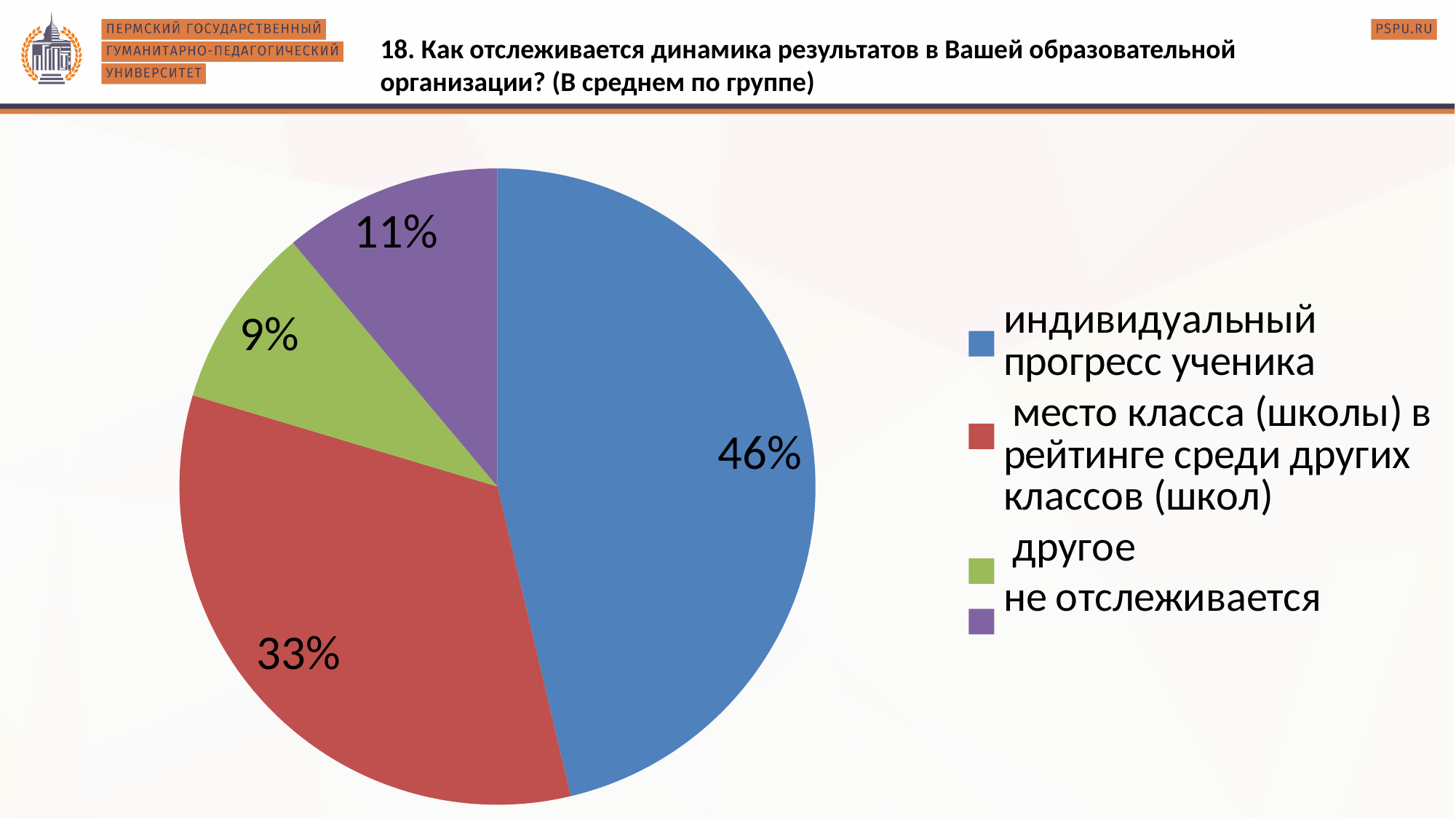
Which category has the smallest slice of the pie? другое How many entries does the legend list? 4 What kind of chart is shown on the slide? pie chart What share of the pie is labelled for "не отслеживается"? 11% Which is larger: the slice for "не отслеживается" or the slice for "другое"? не отслеживается Which category has the largest slice of the pie? индивидуальный прогресс ученика What is the difference in percentage points between "индивидуальный прогресс ученика" and "место класса (школы) в рейтинге среди других классов (школ)"? 13 How many slices does the pie chart have? 4 What share of the pie is labelled for "место класса (школы) в рейтинге среди других классов (школ)"? 33% What colour is the slice for "место класса (школы) в рейтинге среди других классов (школ)"? red What share of the pie is labelled for "другое"? 9% What share of the pie is labelled for "индивидуальный прогресс ученика"? 46%